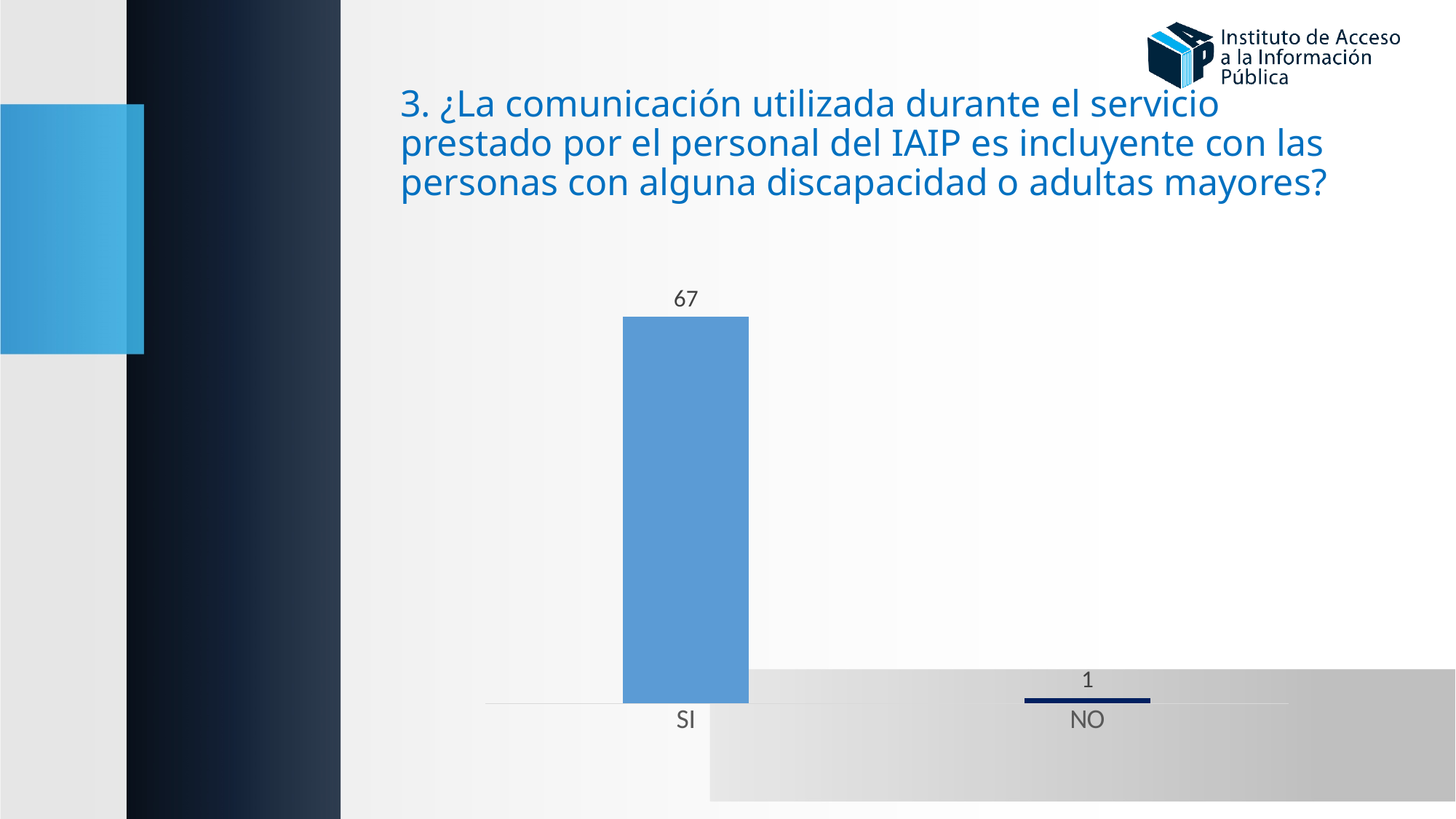
What kind of chart is shown on the slide? Bar chart Which is larger, the value for SI or the value for NO? SI What is the total of the values for SI and NO? 68 What is the difference between the values for SI and NO? 66 What are the two category labels on the x axis? SI and NO Which category has the lowest value? NO What colour is the bar for SI? Blue What is the value for NO? 1 Which category has the highest value? SI How many categories are shown in the chart? 2 What is the value for SI? 67